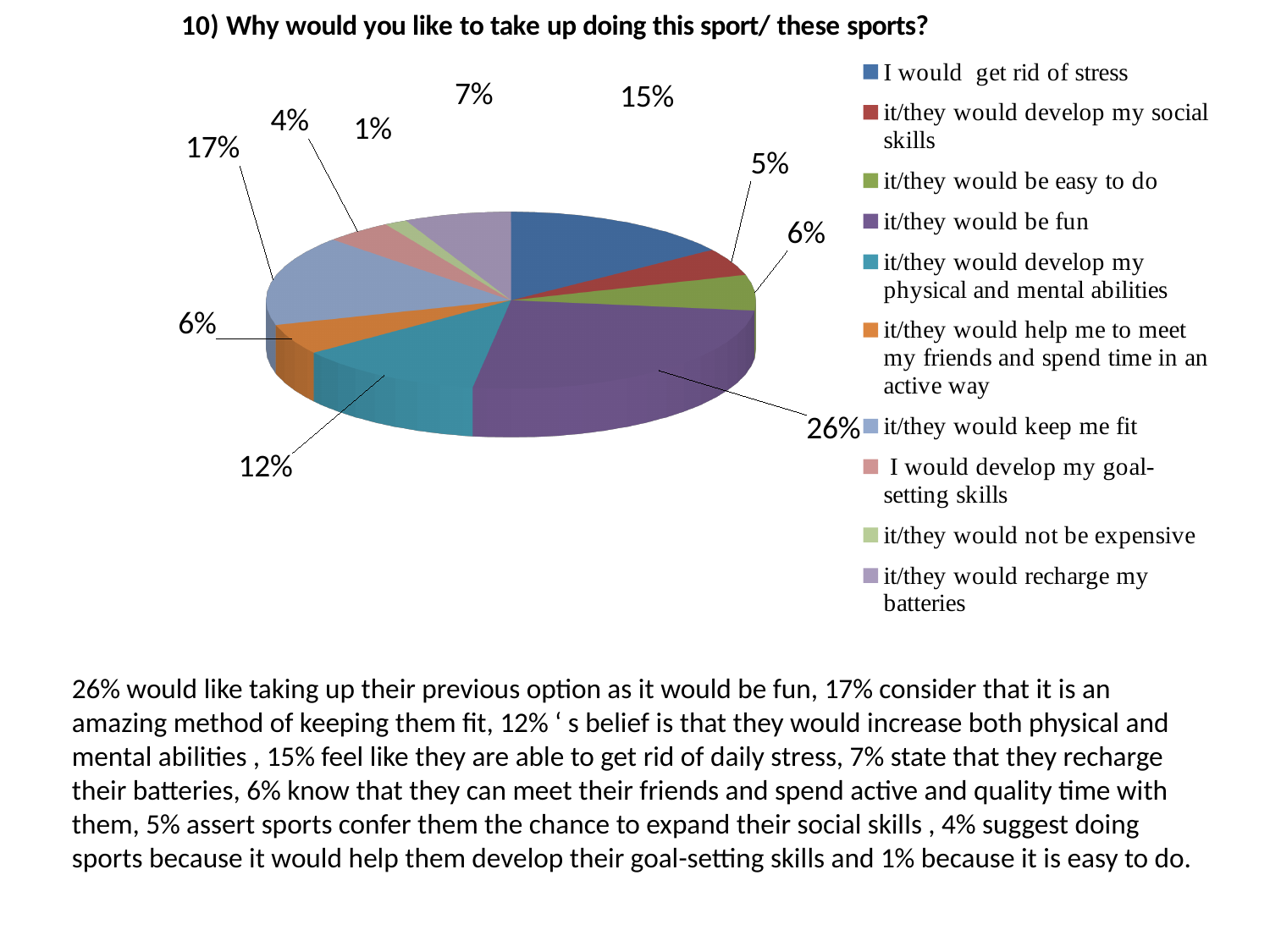
What percentage of respondents said I would get rid of stress? 15% What percentage of respondents said I would develop my goal-setting skills? 4% Which reason has the largest share of the pie? it/they would be fun What percentage of respondents said it/they would be fun? 26% Which is larger: the share for 'I would get rid of stress' or for 'it/they would keep me fit'? it/they would keep me fit Which reason has the smallest share of the pie? it/they would not be expensive What kind of chart is shown on the slide? Pie chart How many percentage points larger is the share for 'it/they would be fun' than for 'it/they would keep me fit'? 9 What percentage of respondents said it/they would keep me fit? 17% How many categories does the legend of the pie chart list? 10 What percentage of respondents said it/they would recharge my batteries? 7% What percentage of respondents said it/they would develop my physical and mental abilities? 12%